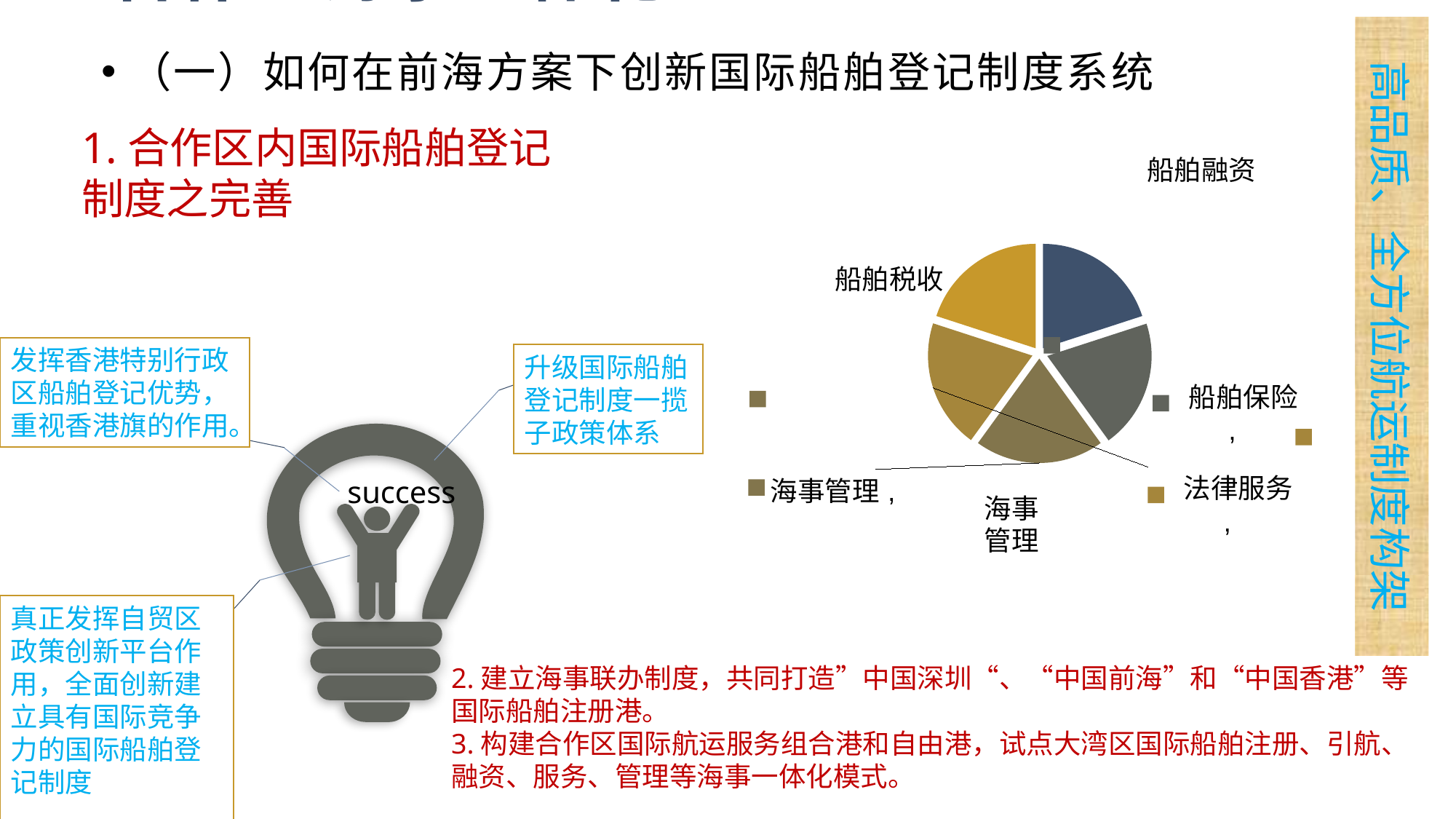
What kind of chart is shown on the right side of the slide? pie chart Which category label appears at the top of the pie chart? 船舶融资 Which category label appears to the upper left of the pie chart? 船舶税收 How many slices does the pie chart have? 5 Which category of the pie chart is shown in dark blue? 船舶融资 Which category of the pie chart is shown in dark gray? 船舶保险